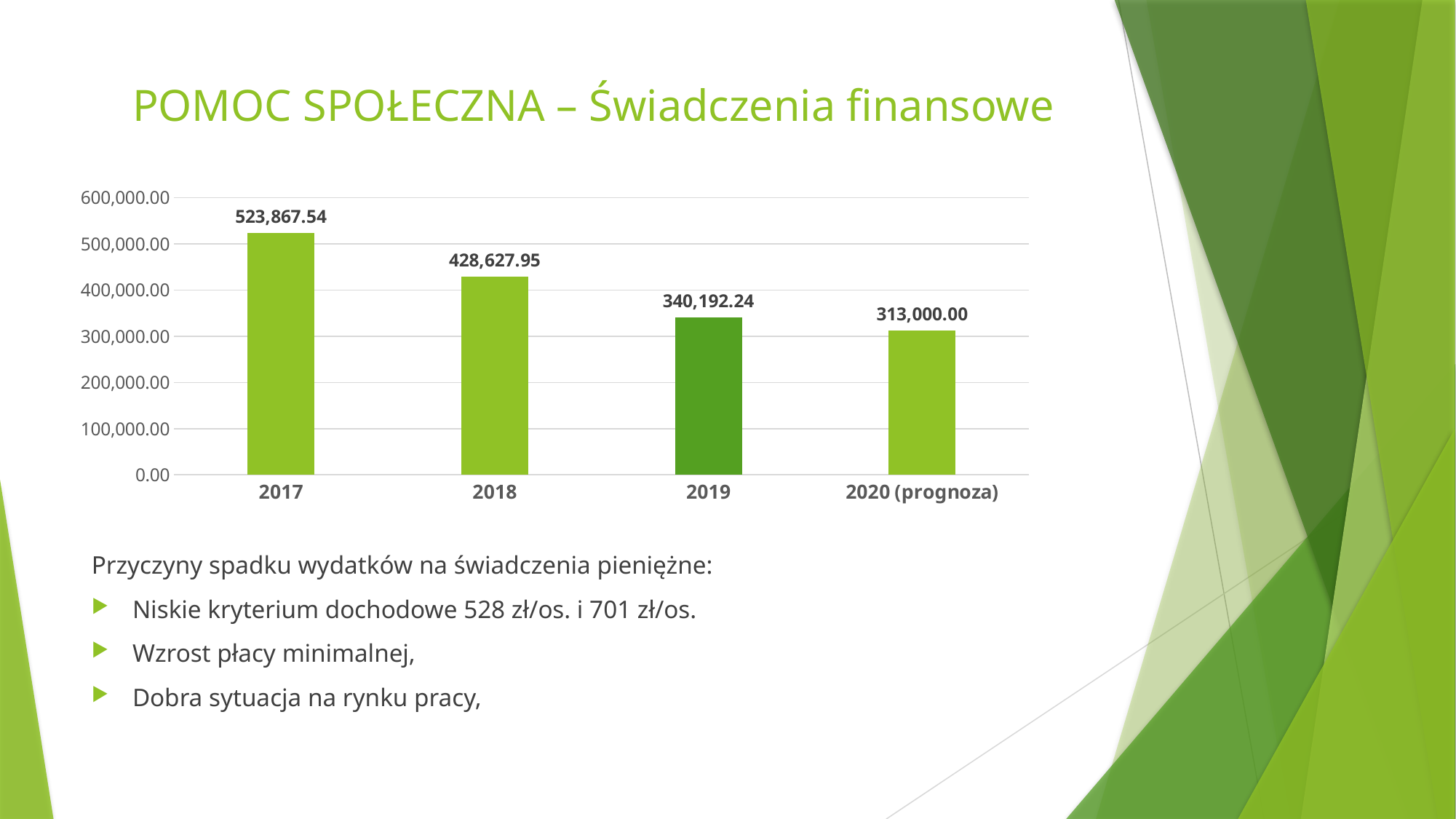
What is the difference between the values for 2017 and 2018? 95,239.59 What is the value shown for 2019? 340,192.24 Which is larger, the value for 2018 or the value for 2019? 2018 What is the value shown for 2017? 523,867.54 Which year has the highest value? 2017 How many bars are shown in the chart? 4 Do the values rise or fall from 2017 to 2020 (prognoza)? fall What is the difference between the values for 2019 and 2020 (prognoza)? 27,192.24 What is the value shown for 2018? 428,627.95 Is the value for 2019 greater or less than 300,000.00? greater What is the value shown for 2020 (prognoza)? 313,000.00 Which category has the lowest value? 2020 (prognoza)